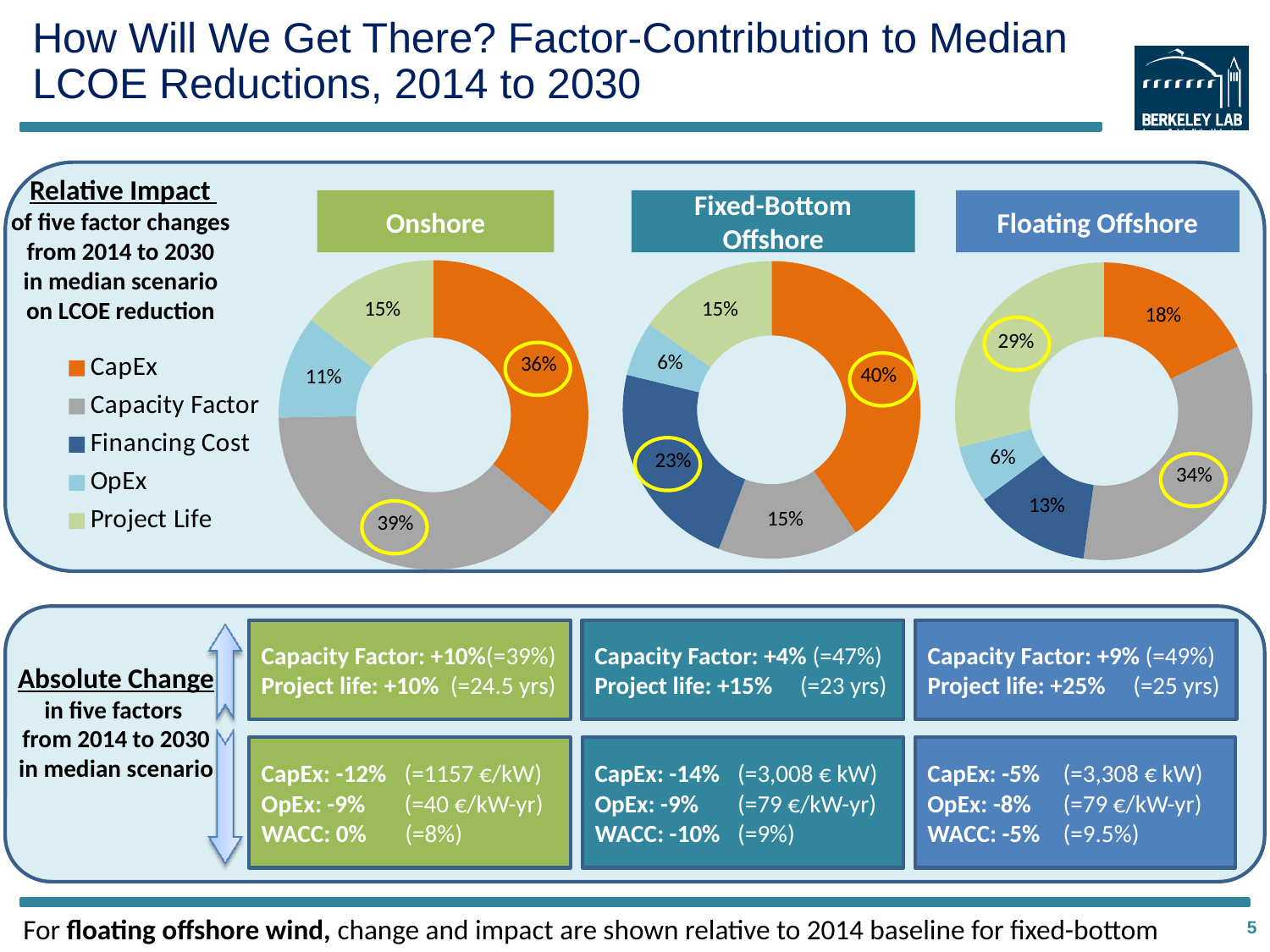
In the Floating Offshore chart, which factor has the smallest share? OpEx Which colour represents Capacity Factor in the legend? Gray In the Fixed-Bottom Offshore chart, which factor has the largest share? CapEx In the Fixed-Bottom Offshore chart, which is larger: the CapEx share or the Financing Cost share? CapEx In the Fixed-Bottom Offshore chart, what share does Financing Cost contribute? 23% In the Onshore chart, what share does CapEx contribute? 36% What type of chart is used to show the relative impact for each wind category? Pie (donut) chart In the Onshore chart, which factor has the smallest labelled share? OpEx In the Onshore chart, what share does Capacity Factor contribute? 39% In the Floating Offshore chart, what share does Project Life contribute? 29% In the Floating Offshore chart, what is the difference between the Capacity Factor share and the Financing Cost share? 21 percentage points How many factors does the legend list? 5